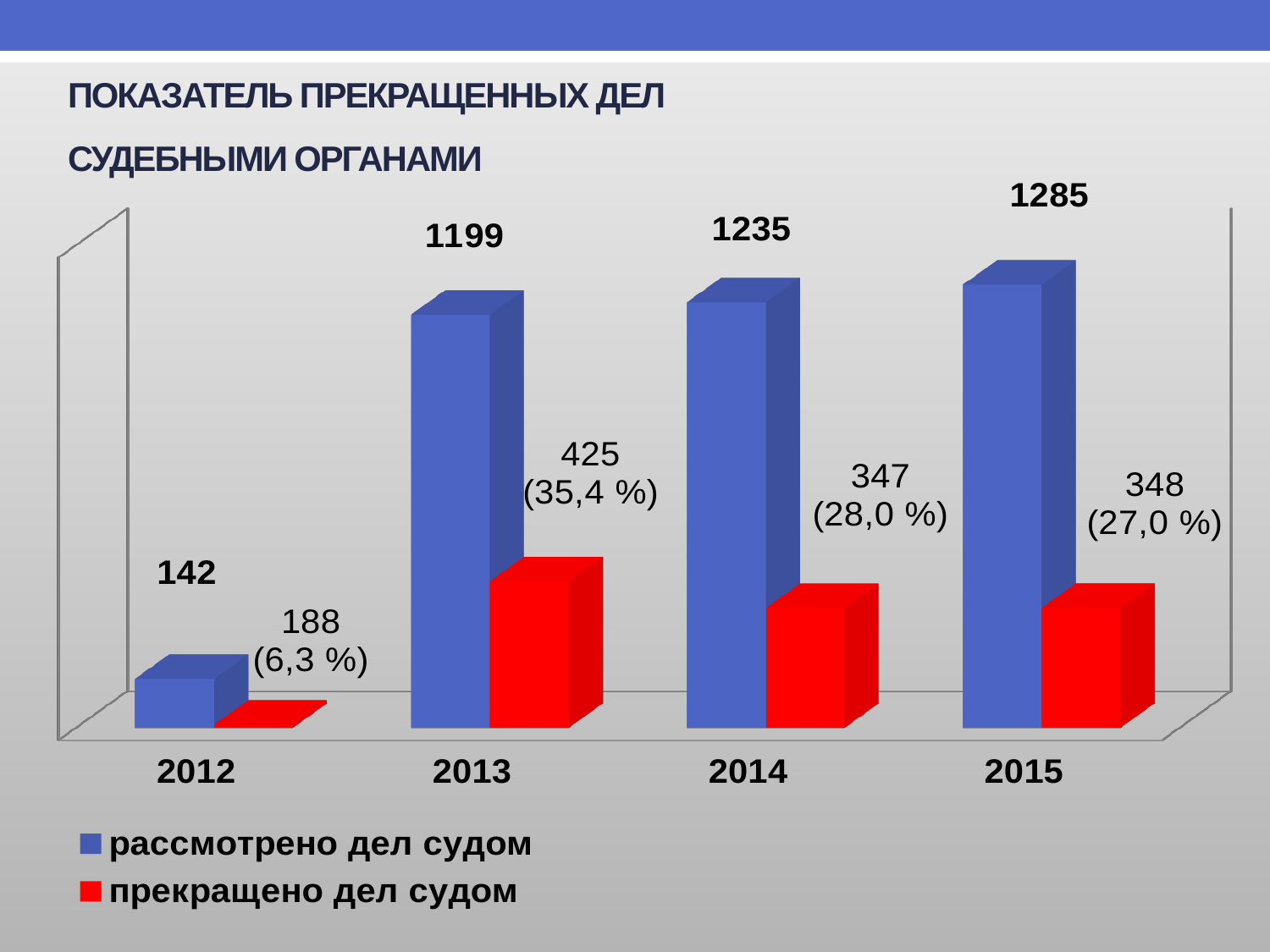
What is the value for "рассмотрено дел судом" in 2013? 1199 Does the "рассмотрено дел судом" series rise or fall from 2012 to 2015? Rise What kind of chart is shown on the slide? Bar chart How many series does the legend list? 2 What is the value for "рассмотрено дел судом" in 2012? 142 What is the difference between the "рассмотрено дел судом" values for 2015 and 2014? 50 What is the value for "прекращено дел судом" in 2014? 347 Which year has the lowest value for "рассмотрено дел судом"? 2012 How many years are shown on the x axis? 4 What percentage is shown next to the "прекращено дел судом" value for 2013? 35,4 % Which year has the highest value for "рассмотрено дел судом"? 2015 Which is larger: the "прекращено дел судом" value for 2013 or for 2015? 2013